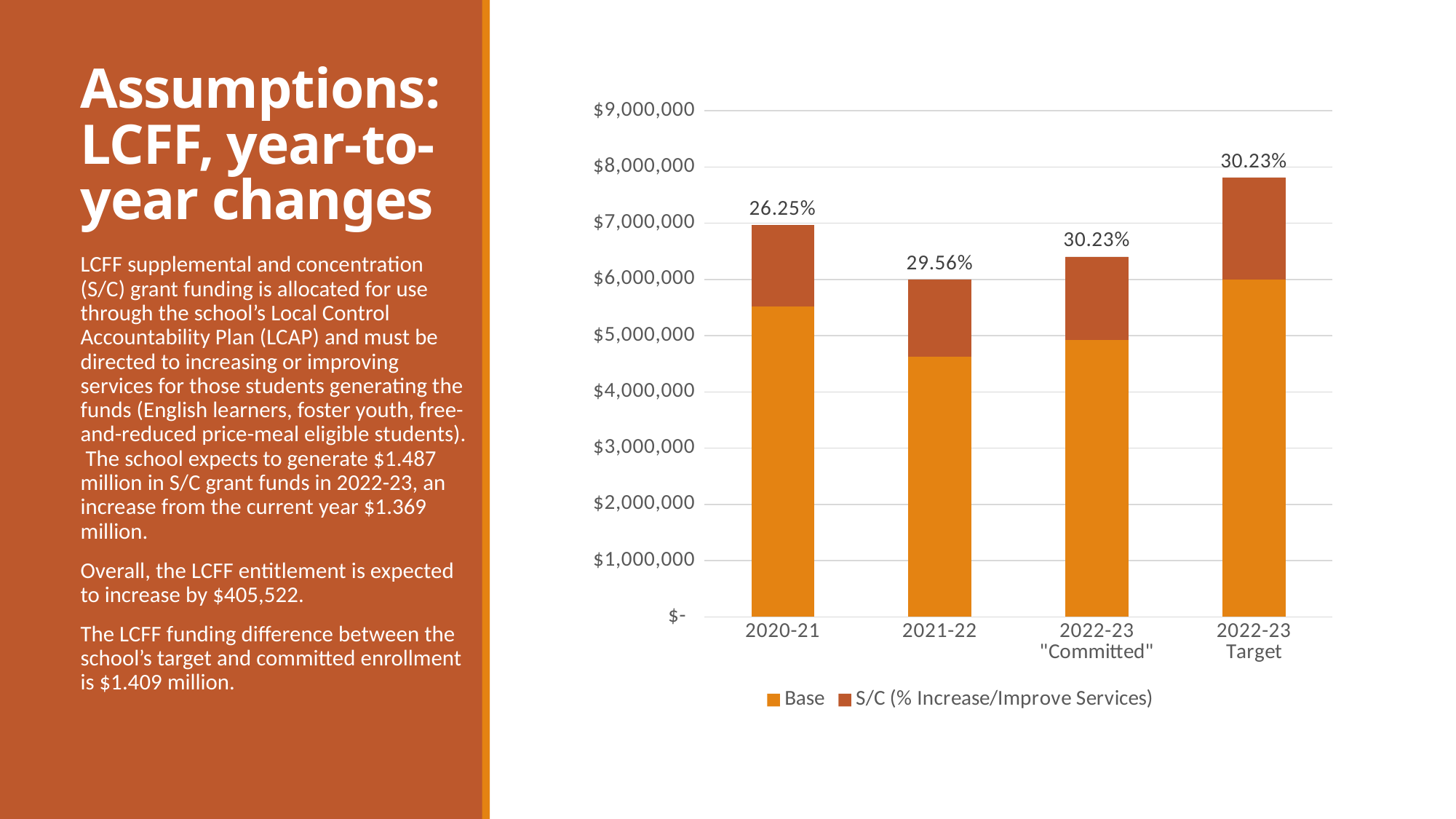
What percentage label is shown above the 2022-23 Target bar? 30.23% Is the Base value for 2021-22 greater or less than $5,000,000? less What percentage label is shown above the 2020-21 bar? 26.25% Which stacked bar is taller overall, 2020-21 or 2022-23 "Committed"? 2020-21 What is the difference between the percentage labels for 2022-23 "Committed" and 2020-21? 3.98% Which category has the lowest percentage label? 2020-21 How many series does the legend list? 2 Which category has the shortest stacked bar overall? 2021-22 How many categories are shown on the x axis? 4 What percentage label is shown above the 2021-22 bar? 29.56% Is the total stacked bar for 2022-23 Target greater or less than $7,000,000? greater Which category has the tallest stacked bar overall? 2022-23 Target